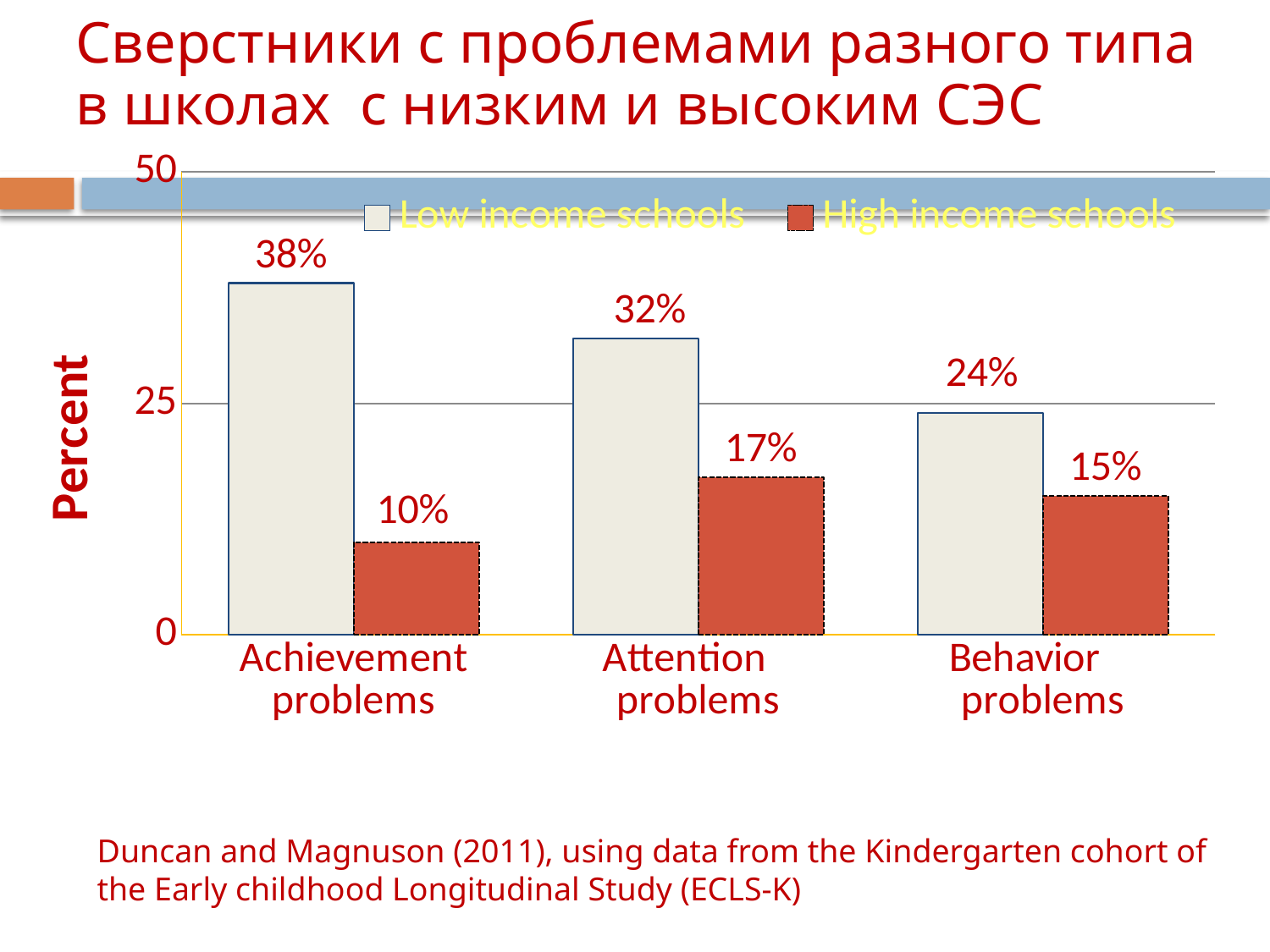
What is the value for High income schools for Behavior problems? 15% What kind of chart is shown on the slide? bar chart Which category has the lowest value for High income schools? Achievement problems What is the value for Low income schools for Achievement problems? 38% Is the value for Low income schools for Attention problems greater or less than 25? greater What is the difference between Low income schools and High income schools for Achievement problems? 28% How many categories are shown on the x axis? 3 What is the value for High income schools for Attention problems? 17% How many series does the legend list? 2 Which is larger for Attention problems: Low income schools or High income schools? Low income schools Which category has the highest value for Low income schools? Achievement problems What is the difference between Low income schools and High income schools for Behavior problems? 9%